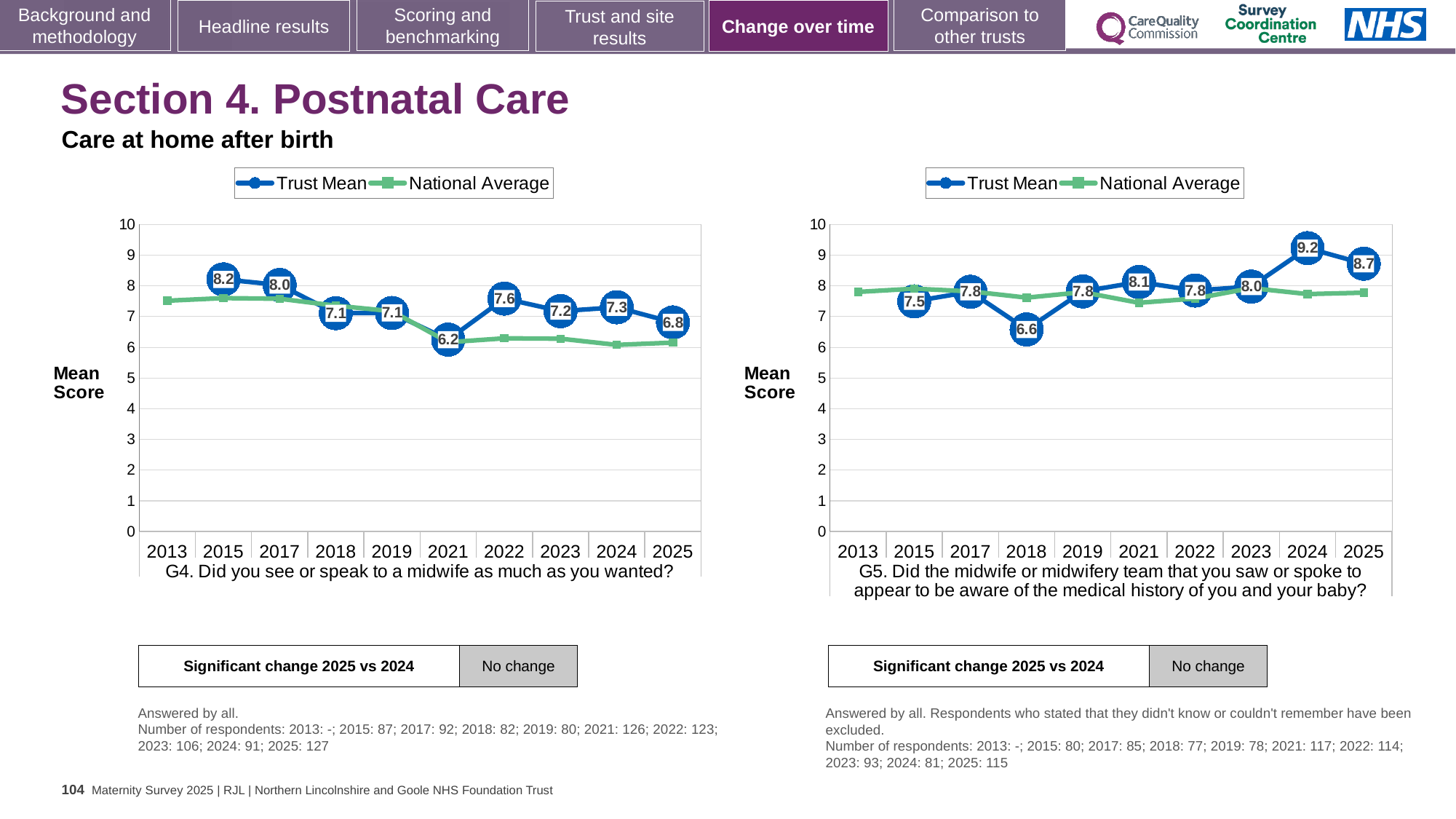
In the G4 chart, is the National Average for 2024 greater or less than 7? less In the G5 chart, what is the difference between the Trust Mean scores for 2024 and 2018? 2.6 What kind of chart is the G5 chart? Line chart In the G4 chart, which year has the highest Trust Mean score? 2015 In the G4 chart, what is the Trust Mean score for 2025? 6.8 In the G5 chart, what is the Trust Mean score for 2024? 9.2 How many series does the legend of the G5 chart list? 2 How many years are shown on the x axis of the G4 chart? 10 In the G5 chart, which year has the lowest Trust Mean score? 2018 In the G4 chart, which year has the lowest Trust Mean score? 2021 In the G5 chart, which is larger, the Trust Mean for 2024 or for 2025? 2024 In the G4 chart, what is the difference between the Trust Mean scores for 2015 and 2021? 2.0